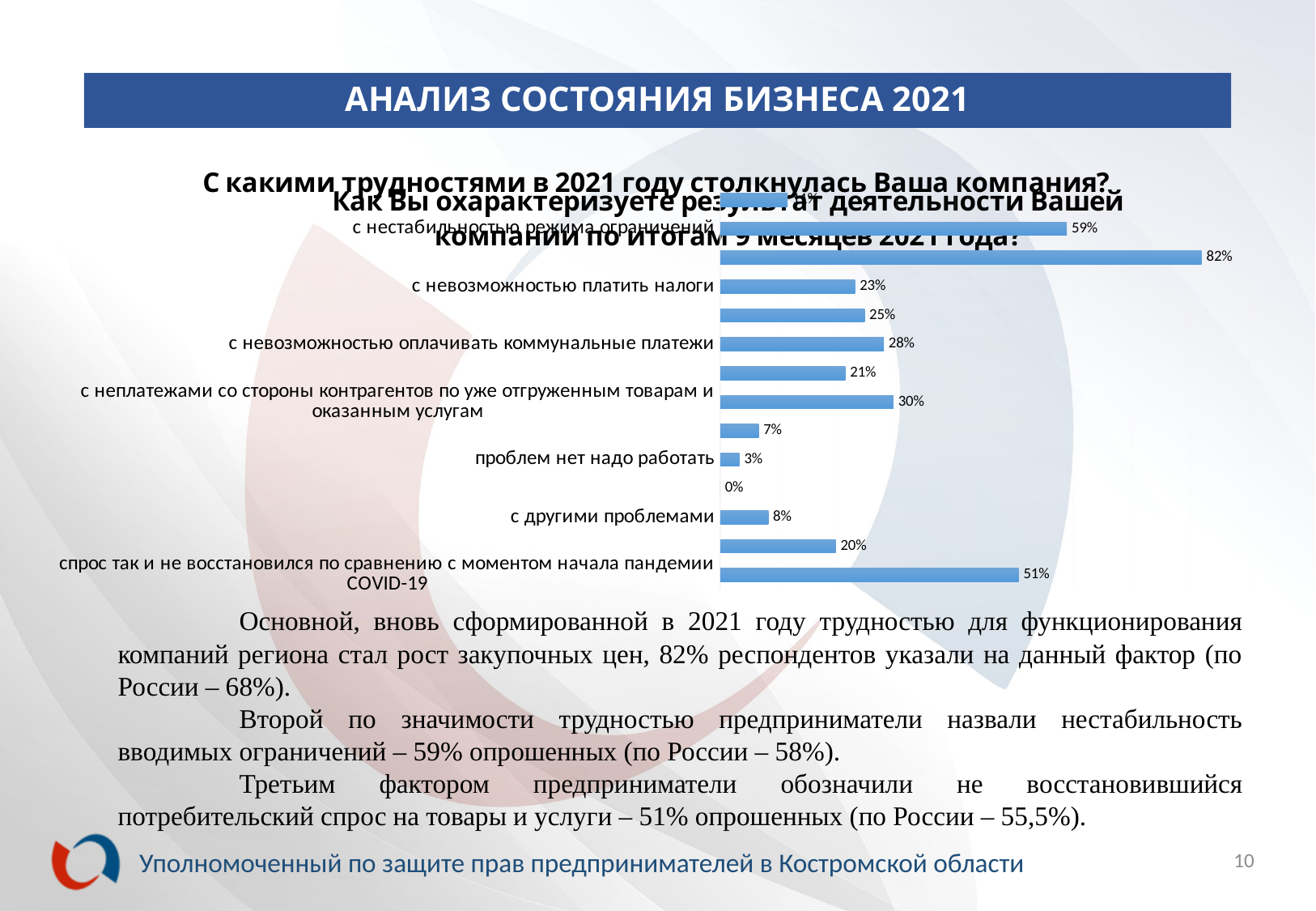
What value is shown for 'с невозможностью платить налоги'? 23% By how many percentage points does 'с нестабильностью режима ограничений' exceed 'спрос так и не восстановился по сравнению с моментом начала пандемии COVID-19'? 8 percentage points Which is larger: the value for 'с невозможностью оплачивать коммунальные платежи' or for 'с невозможностью платить налоги'? с невозможностью оплачивать коммунальные платежи What is the highest value printed on the chart? 82% What value is shown for 'с другими проблемами'? 8% What value is shown for 'с невозможностью оплачивать коммунальные платежи'? 28% What percentage of respondents reported difficulties with the instability of the restriction regime (с нестабильностью режима ограничений)? 59% What is the lowest value printed on the chart? 0% What percentage is shown for non-payments by counterparties for already shipped goods and rendered services? 30% What type of chart is shown on the slide? Bar chart What percentage of respondents said demand has not recovered compared to the start of the COVID-19 pandemic? 51% What value is shown for 'проблем нет надо работать'? 3%